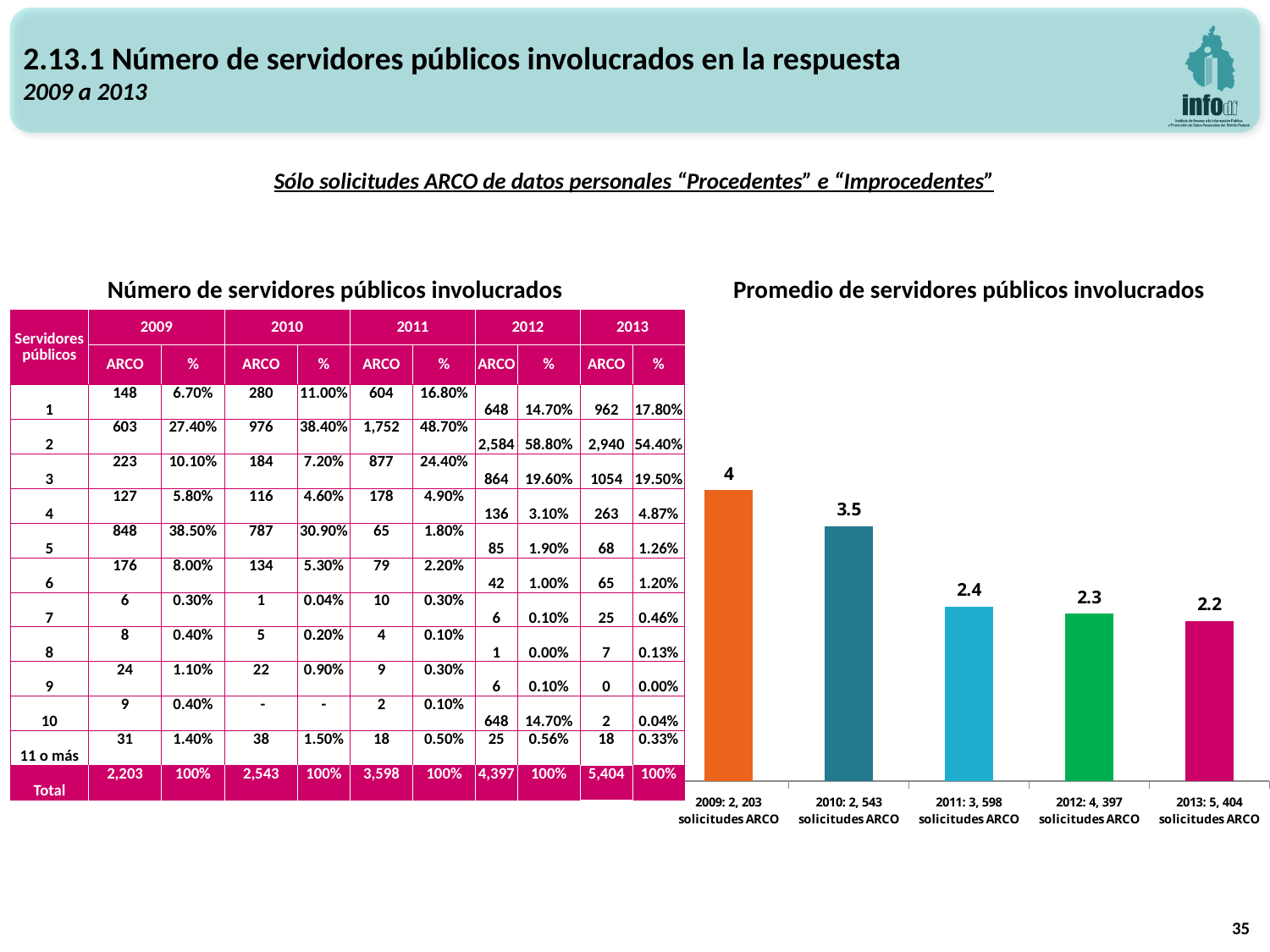
In the chart 'Promedio de servidores públicos involucrados', what is the difference between the values for 2011 and 2013? 0.2 In the chart 'Promedio de servidores públicos involucrados', what is the difference between the values for 2009 and 2010? 0.5 In the chart 'Promedio de servidores públicos involucrados', which is larger, the value for 2010 or the value for 2012? 2010 In the chart 'Promedio de servidores públicos involucrados', what is the value for 2009? 4 In the chart 'Promedio de servidores públicos involucrados', what is the value for 2013? 2.2 How many bars are shown in the chart 'Promedio de servidores públicos involucrados'? 5 In the chart 'Promedio de servidores públicos involucrados', what is the value for 2010? 3.5 In the chart 'Promedio de servidores públicos involucrados', do the values rise or fall from 2009 to 2013? Fall In the chart 'Promedio de servidores públicos involucrados', what is the value for 2011? 2.4 In the chart 'Promedio de servidores públicos involucrados', which year has the highest value? 2009 In the chart 'Promedio de servidores públicos involucrados', which year has the lowest value? 2013 What kind of chart is 'Promedio de servidores públicos involucrados'? Bar chart